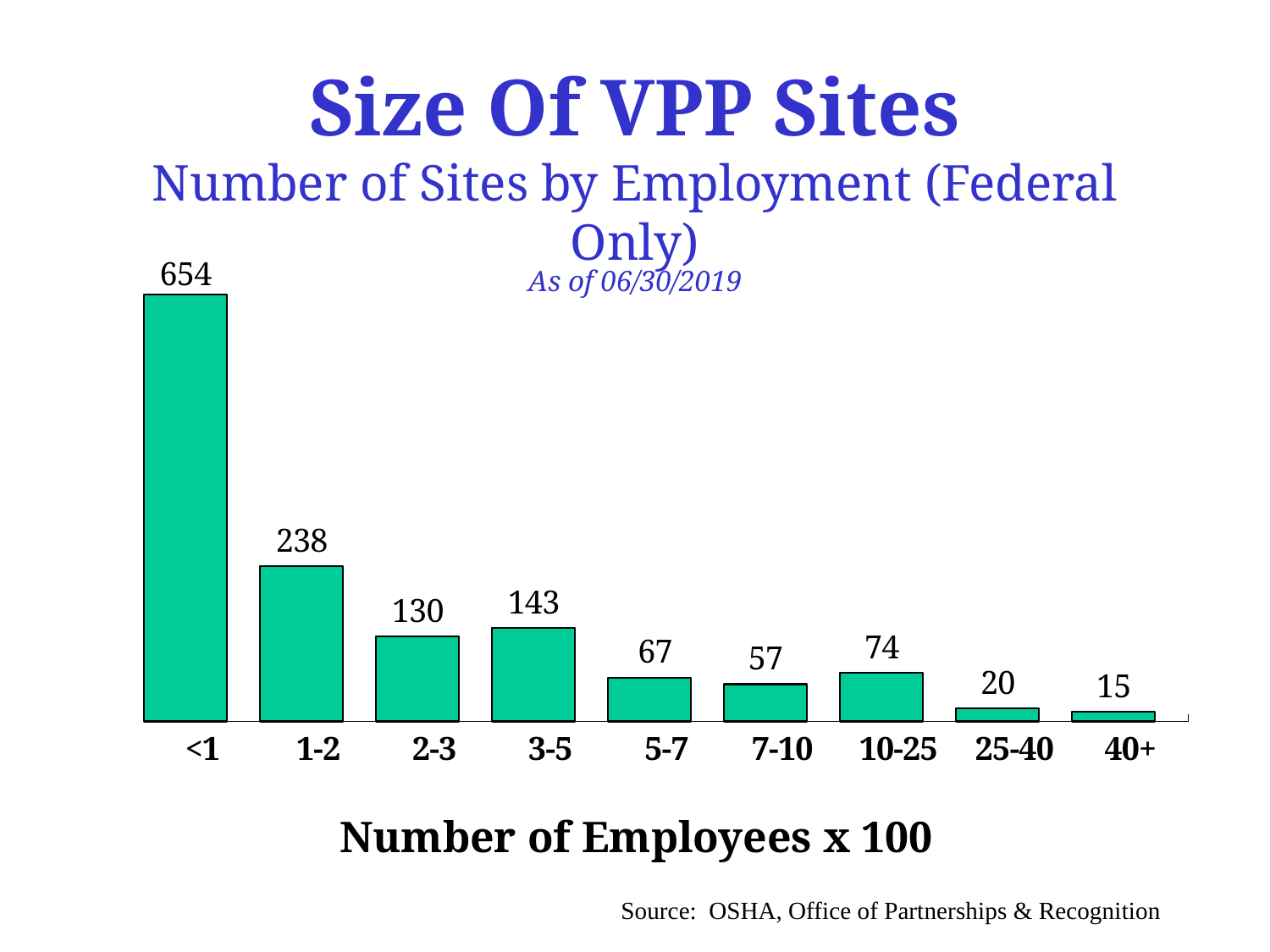
Which category has more sites, 2-3 or 3-5? 3-5 What is the number of sites for the 3-5 category? 143 Which category has more sites, 5-7 or 10-25? 10-25 What type of chart is shown on the slide? Bar chart Which employment category has the highest number of sites? <1 How many VPP sites are in the <1 employment category (Number of Employees x 100)? 654 How many employment categories are shown on the x axis? 9 What is the difference in number of sites between the <1 and 1-2 categories? 416 Which employment category has the lowest number of sites? 40+ What is the difference in number of sites between the 3-5 and 2-3 categories? 13 What is the x-axis title of the chart? Number of Employees x 100 What is the number of sites for the 25-40 category? 20